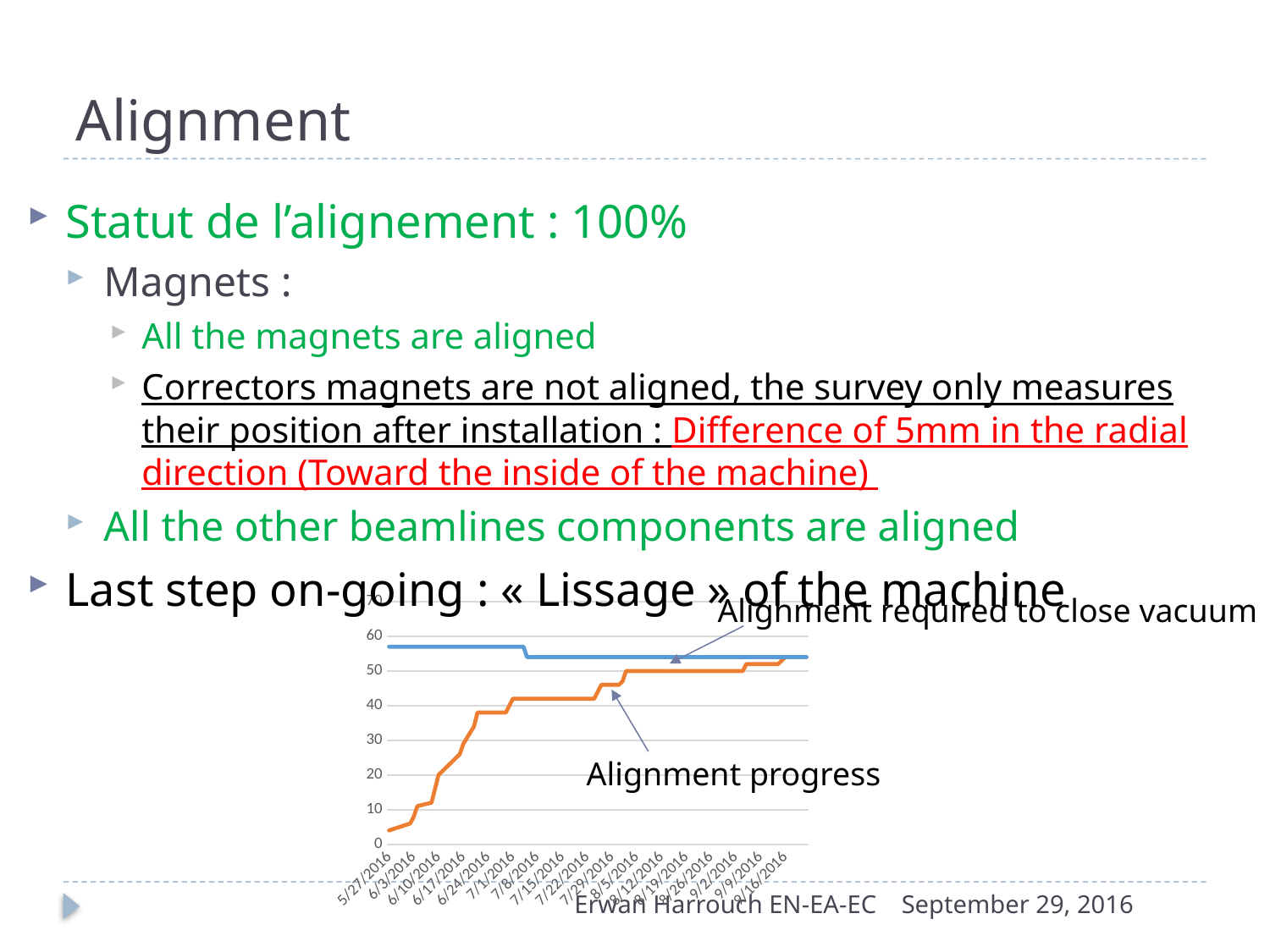
What kind of chart is shown on the slide? line chart How many date ticks are shown along the x axis of the chart? 17 Is the value of 'Alignment required to close vacuum' at 5/27/2016 greater or less than 60? less How many lines (series) are plotted on the chart? 2 At 6/10/2016, which line is higher: 'Alignment required to close vacuum' or 'Alignment progress'? Alignment required to close vacuum What is the highest value shown on the y axis of the chart? 70 What is the first date shown on the x axis of the chart? 5/27/2016 What colour is the 'Alignment progress' line? orange Is the value of 'Alignment progress' at 5/27/2016 greater or less than 10? less Is the value of 'Alignment required to close vacuum' at 9/16/2016 greater or less than 50? greater Does the 'Alignment progress' line rise or fall from 5/27/2016 to 9/16/2016? rises